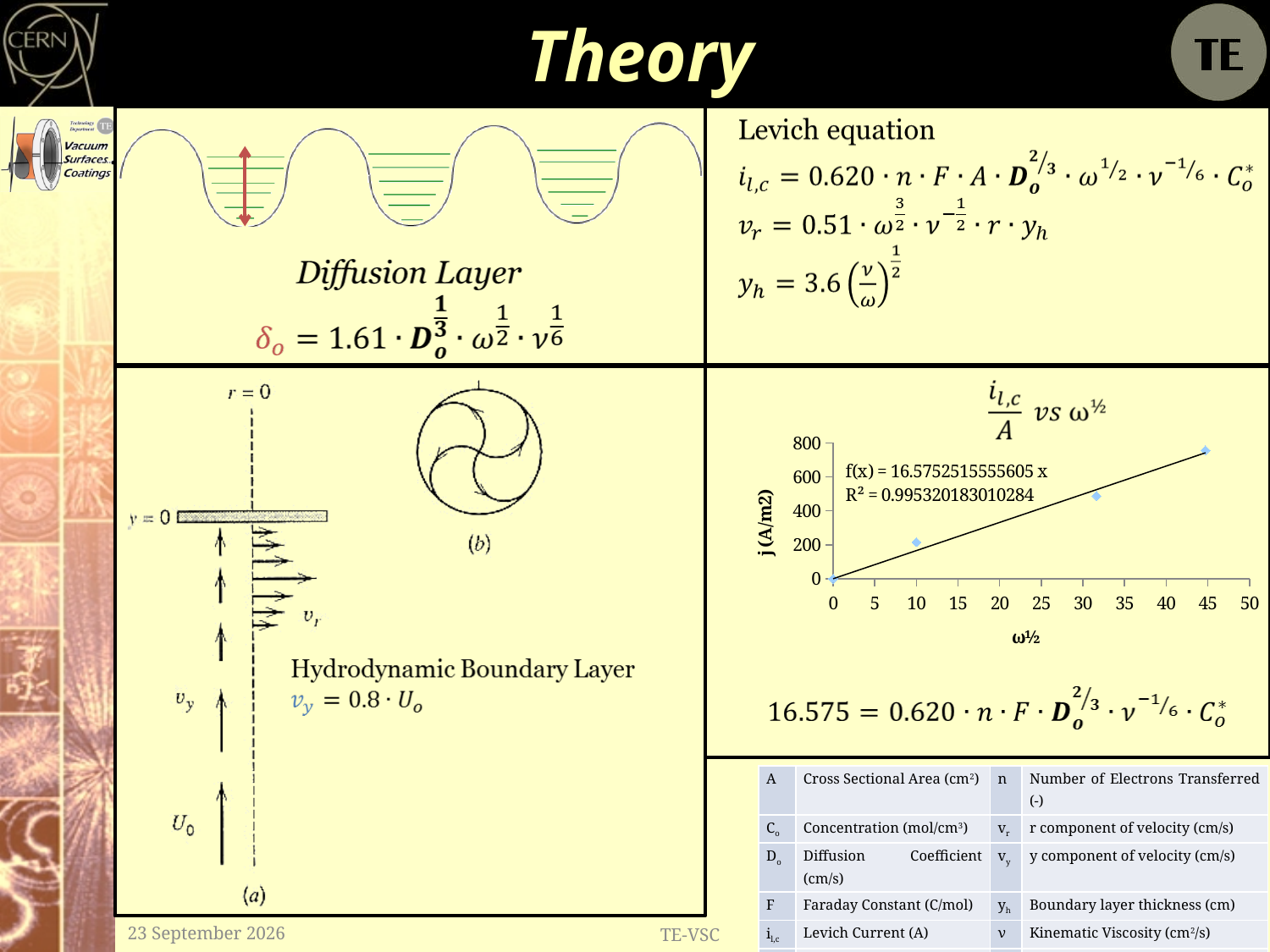
Is the value of the data point at ω½ of about 45 greater or less than 600? greater Which data point has the highest j value: the one at ω½ of about 10 or the one at ω½ of about 45? the one at ω½ of about 45 What is the maximum value shown on the y axis of the chart? 800 What is the label of the x axis of the chart? ω½ Is the value of the data point at ω½ of about 10 greater or less than 400? less How many data points are plotted in the chart? 4 Do the plotted values rise or fall as ω½ increases along the x axis? rise What kind of chart is shown on the slide? scatter chart What is the label of the y axis of the chart? j (A/m2) Is the value of the data point at ω½ of about 31 greater or less than 400? greater